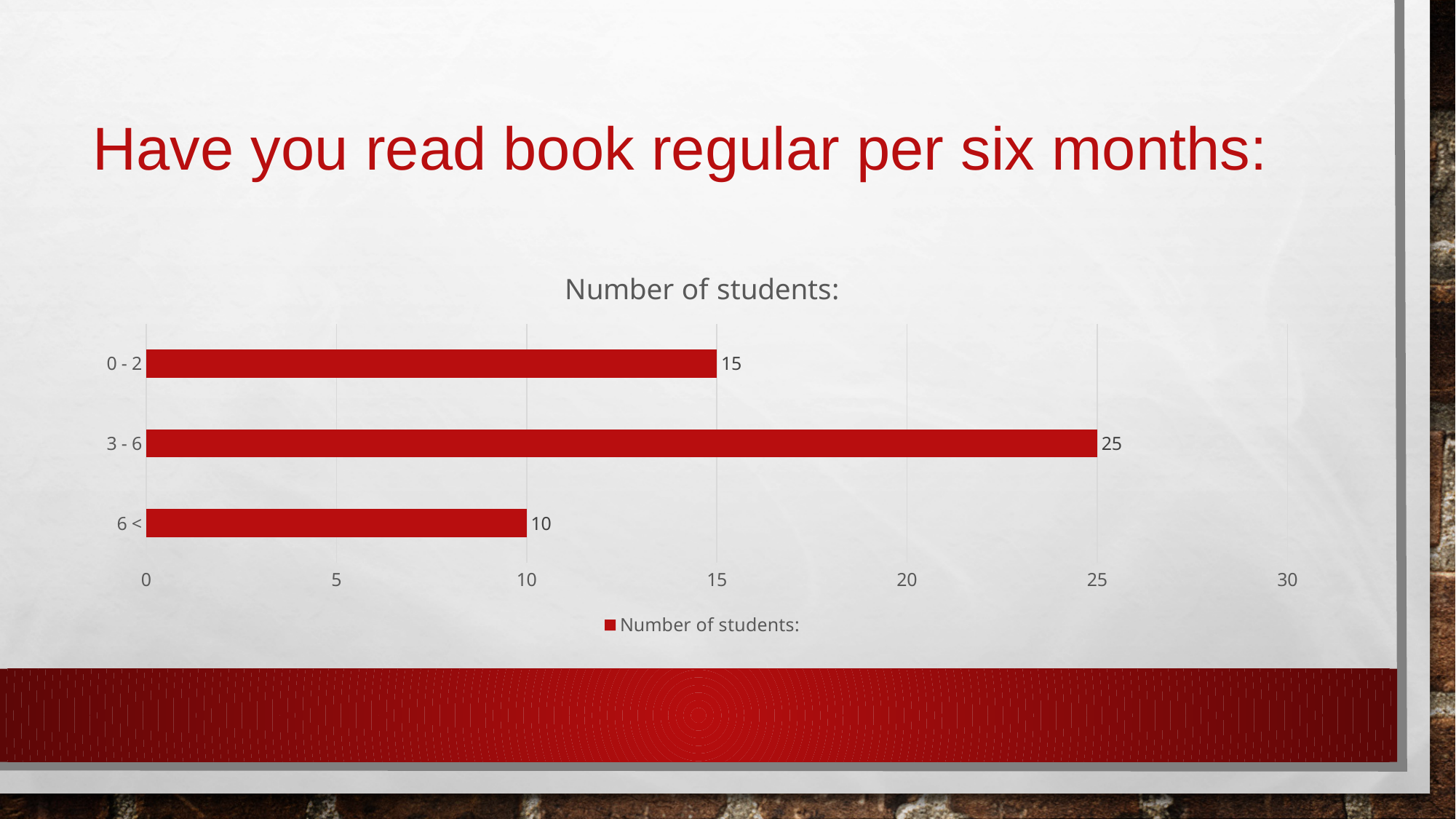
Which category has the lowest number of students? 6 < What is the number of students for the category 0 - 2? 15 Which category has the highest number of students? 3 - 6 What is the number of students for the category 3 - 6? 25 What is the title of the chart? Number of students: What is the difference in number of students between the 3 - 6 and 0 - 2 categories? 10 What is the difference in number of students between the 0 - 2 and 6 < categories? 5 What is the number of students for the category 6 <? 10 Which category has more students, 0 - 2 or 6 <? 0 - 2 What kind of chart is shown on the slide? Bar chart Is the value for 3 - 6 greater or less than 20? greater How many categories are shown in the chart? 3